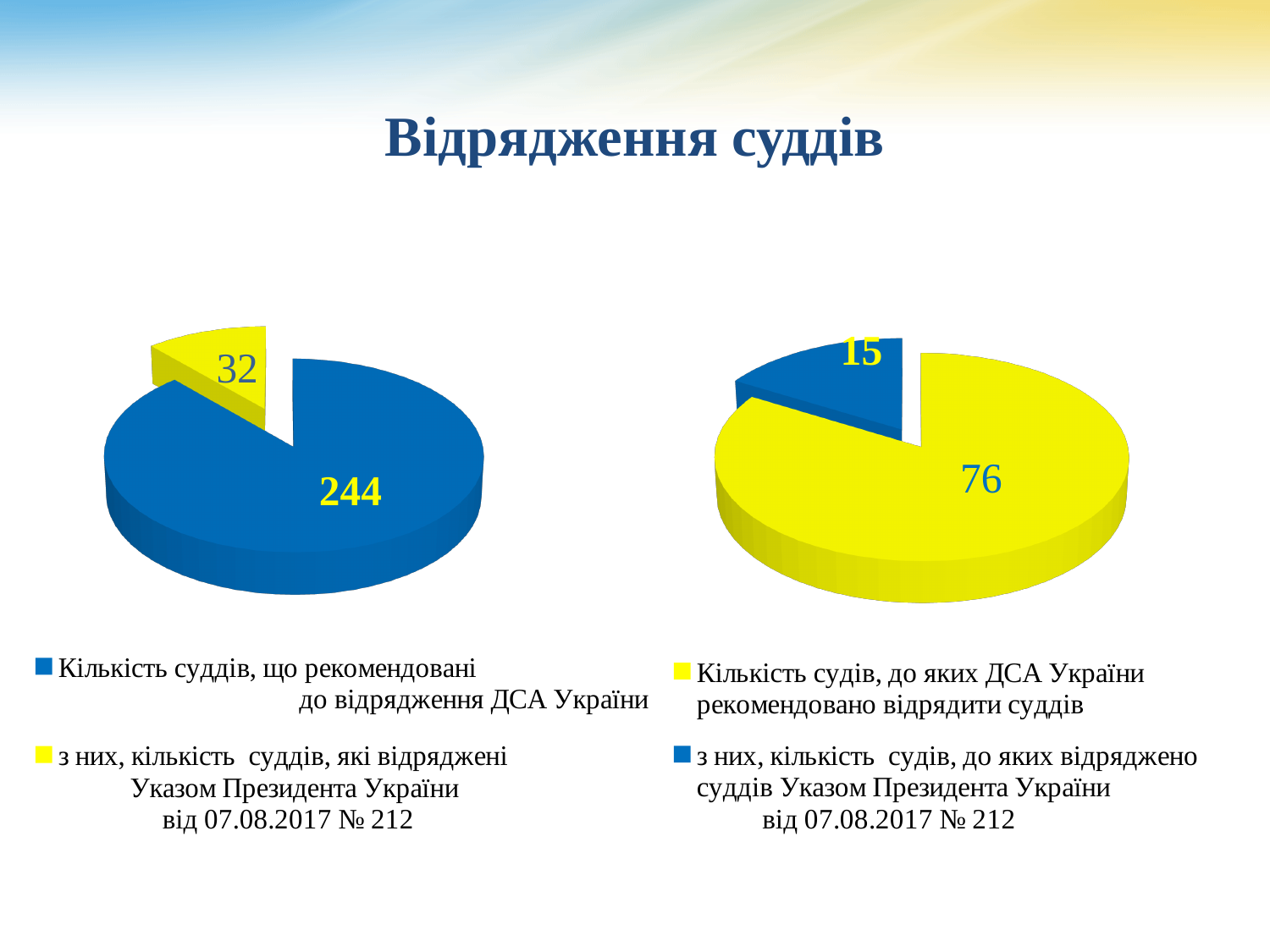
In the right pie chart, which slice is the smallest? з них, кількість судів, до яких відряджено суддів Указом Президента України від 07.08.2017 № 212 What type of chart is shown on the left of the slide? Pie chart In the right pie chart, what is the value for 'з них, кількість судів, до яких відряджено суддів Указом Президента України від 07.08.2017 № 212'? 15 What is the title of the slide above the two pie charts? Відрядження суддів Which is larger: the value 244 in the left pie chart or the value 76 in the right pie chart? 244 In the left pie chart, what is the value for 'з них, кількість суддів, які відряджені Указом Президента України від 07.08.2017 № 212'? 32 In the right pie chart, what is the value for 'Кількість судів, до яких ДСА України рекомендовано відрядити суддів'? 76 In the left pie chart, what is the difference between the two slice values, 244 and 32? 212 In the left pie chart, what is the value for 'Кількість суддів, що рекомендовані до відрядження ДСА України'? 244 In the right pie chart, what is the difference between the two slice values, 76 and 15? 61 In the left pie chart, which slice is the largest? Кількість суддів, що рекомендовані до відрядження ДСА України What type of chart is shown on the right of the slide? Pie chart